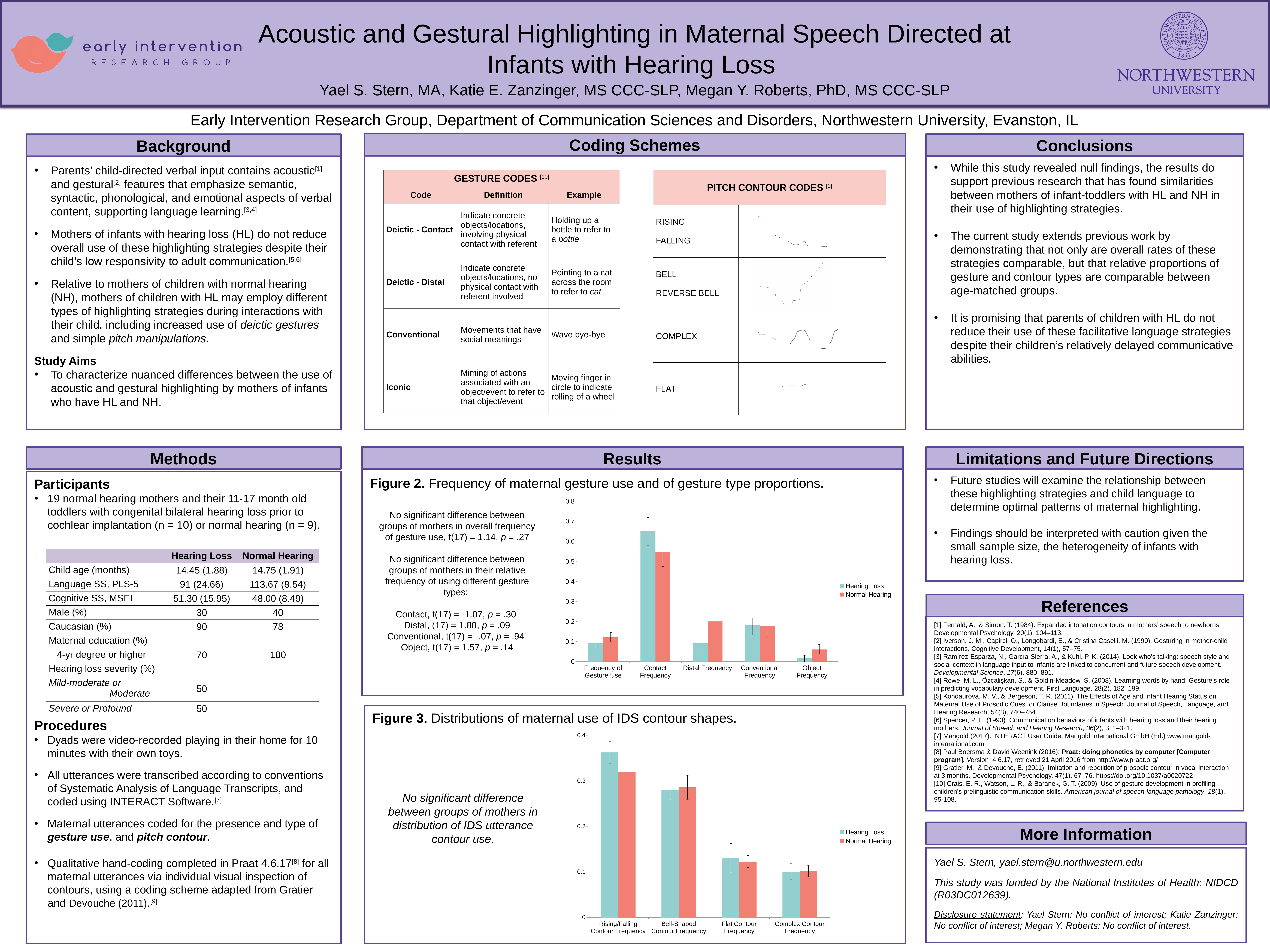
In Figure 2, is the Normal Hearing value for Contact Frequency greater or less than 0.6? less In Figure 3, do the Hearing Loss values rise or fall from left to right along the x axis? fall In Figure 3, is the Hearing Loss value for Rising/Falling Contour Frequency greater or less than 0.3? greater In Figure 2, for Distal Frequency, which group has the larger value, Hearing Loss or Normal Hearing? Normal Hearing In Figure 2, which category has the lowest value for Hearing Loss? Object Frequency In Figure 2, what kind of chart is used? bar chart In Figure 3, which category has the highest value for Normal Hearing? Rising/Falling Contour Frequency In Figure 3, how many contour categories are shown on the x axis? 4 In Figure 2, is the Hearing Loss value for Contact Frequency greater or less than 0.6? greater In Figure 2, how many categories are shown on the x axis? 5 In Figure 2, which category has the highest value for Hearing Loss? Contact Frequency In Figure 2, how many series does the legend list? 2